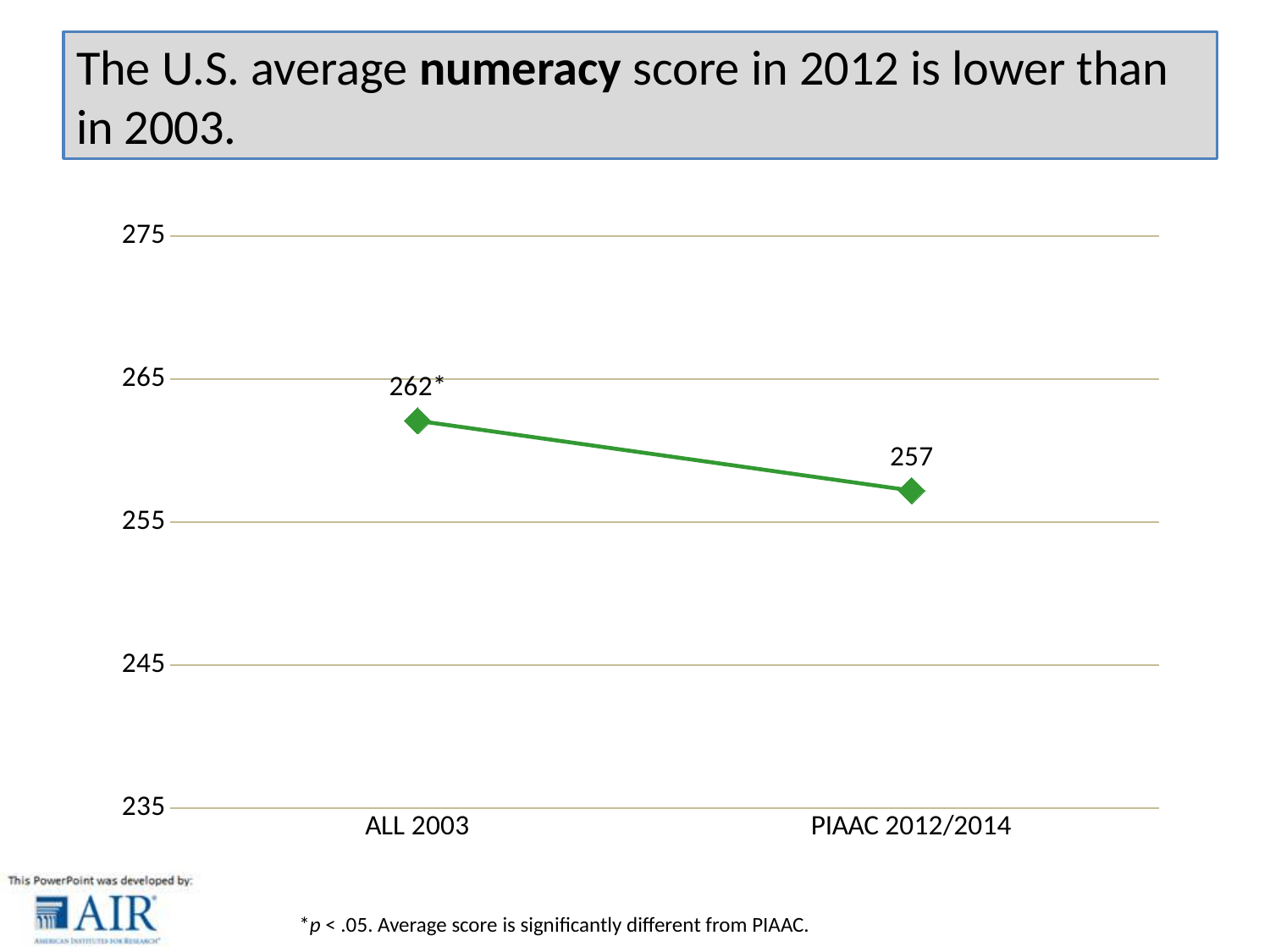
Do the values rise or fall from ALL 2003 to PIAAC 2012/2014? fall What is the value for PIAAC 2012/2014? 257 Which category has the highest value? ALL 2003 Which category has the lowest value? PIAAC 2012/2014 What is the value for ALL 2003? 262* What kind of chart is shown on the slide? line chart Is the value for ALL 2003 greater or less than 265? less Is the value for PIAAC 2012/2014 greater or less than 255? greater What does the asterisk next to the 262 data label indicate, according to the footnote? p < .05. Average score is significantly different from PIAAC. How many data points are plotted on the chart? 2 What is the difference between the ALL 2003 value and the PIAAC 2012/2014 value? 5 Which is larger, the value for ALL 2003 or the value for PIAAC 2012/2014? ALL 2003